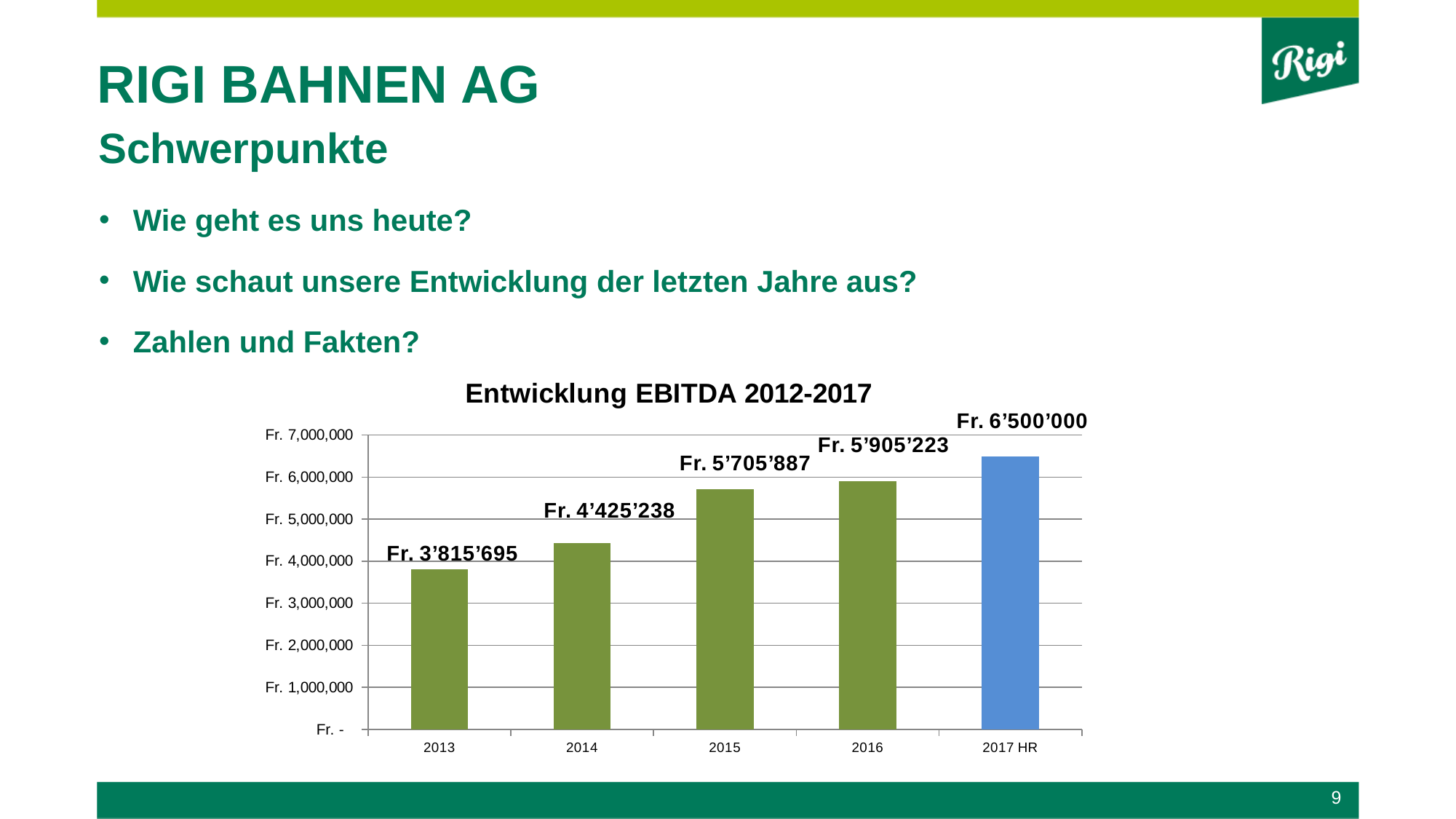
What is the EBITDA value shown for 2017 HR? Fr. 6’500’000 What is the EBITDA value shown for 2015? Fr. 5’705’887 How many years (bars) are shown in the chart? 5 What is the EBITDA value shown for 2013? Fr. 3’815’695 What is the difference between the EBITDA for 2014 and 2013? Fr. 609’543 Which is larger, the EBITDA for 2015 or for 2014? 2015 Which year has the lowest EBITDA in the chart? 2013 Do the EBITDA values rise or fall from 2013 to 2017 HR? rise What is the difference between the EBITDA for 2017 HR and 2016? Fr. 594’777 Which year has the highest EBITDA in the chart? 2017 HR Is the EBITDA value for 2016 greater or less than Fr. 6,000,000? less What kind of chart is used to show the EBITDA development? bar chart